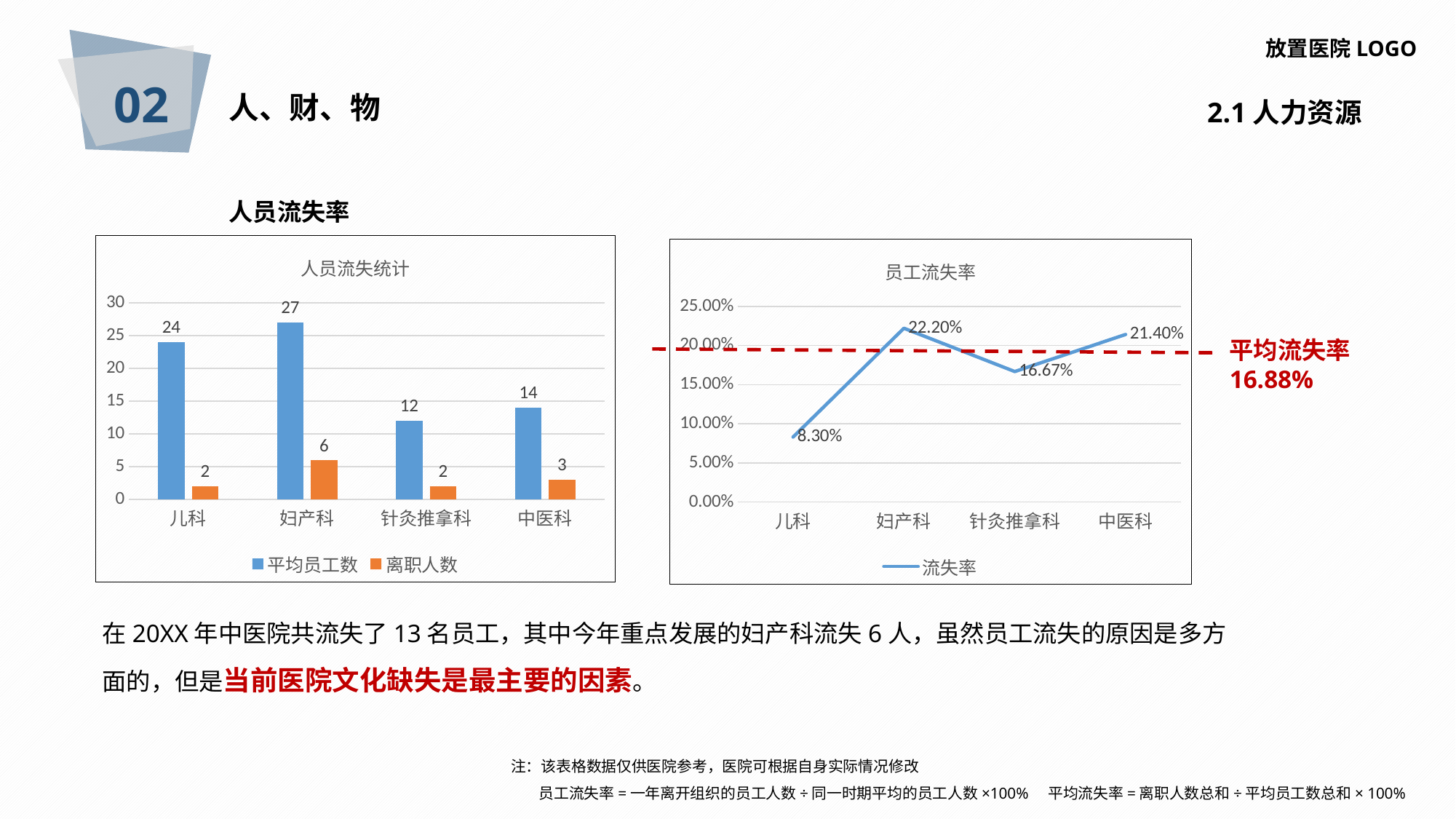
What type of chart is the 人员流失统计 chart? bar chart In the 员工流失率 chart, which category has the highest 流失率? 妇产科 In the 人员流失统计 chart, which category has the highest 平均员工数? 妇产科 In the 人员流失统计 chart, how many series does the legend list? 2 In the 人员流失统计 chart, what is the difference between the 平均员工数 of 儿科 and 中医科? 10 In the 员工流失率 chart, how many categories are shown on the x axis? 4 In the 员工流失率 chart, is the 流失率 for 儿科 greater or less than 10.00%? less In the 员工流失率 chart, which category has the lowest 流失率? 儿科 In the 人员流失统计 chart, what is the 离职人数 value for 中医科? 3 In the 人员流失统计 chart, which category has the lowest 平均员工数? 针灸推拿科 In the 人员流失统计 chart, what is the 平均员工数 value for 妇产科? 27 In the 员工流失率 chart, what is the 流失率 for 针灸推拿科? 16.67%